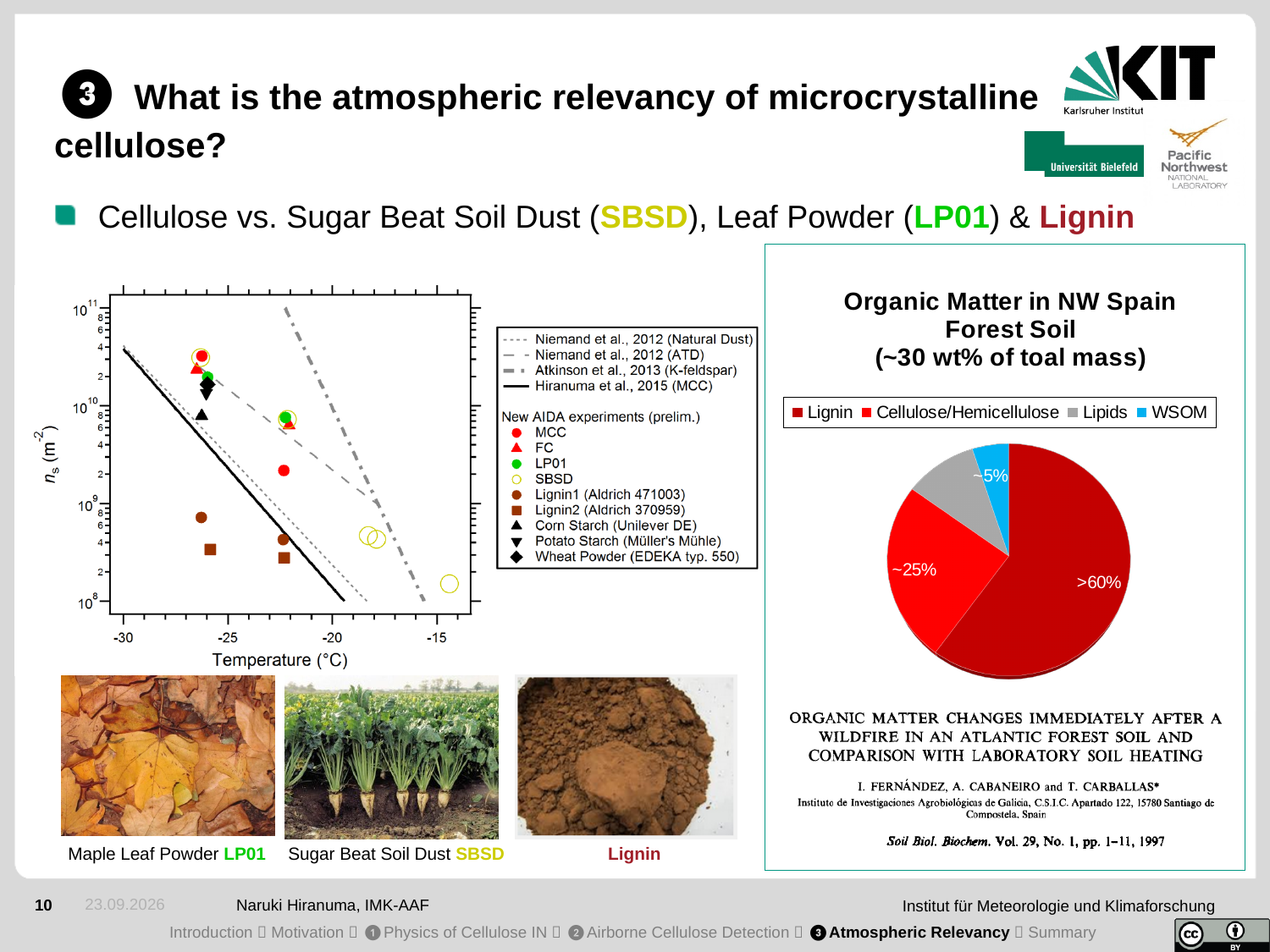
What kind of chart is the plot on the left of the slide showing n_s versus Temperature? scatter plot In the scatter plot of n_s versus Temperature, what is the label of the x axis? Temperature (°C) In the pie chart 'Organic Matter in NW Spain Forest Soil', which component has the largest share? Lignin In the pie chart 'Organic Matter in NW Spain Forest Soil', which slice is labelled ~5%? WSOM In the pie chart 'Organic Matter in NW Spain Forest Soil', what share label is printed on the Cellulose/Hemicellulose slice? ~25% In the pie chart 'Organic Matter in NW Spain Forest Soil', what colour is the WSOM slice? blue In the pie chart 'Organic Matter in NW Spain Forest Soil', how many categories does the legend list? 4 In the scatter plot of n_s versus Temperature, is the SBSD value at about -15 °C greater or less than 10^9 m^-2? less What kind of chart is shown on the right side of the slide under the title 'Organic Matter in NW Spain Forest Soil'? pie chart In the pie chart 'Organic Matter in NW Spain Forest Soil', what share label is printed on the Lignin slice? >60% In the scatter plot of n_s versus Temperature, how many 'New AIDA experiments (prelim.)' sample types are listed in the legend? 9 In the pie chart 'Organic Matter in NW Spain Forest Soil', which is larger: the Cellulose/Hemicellulose slice or the Lipids slice? Cellulose/Hemicellulose